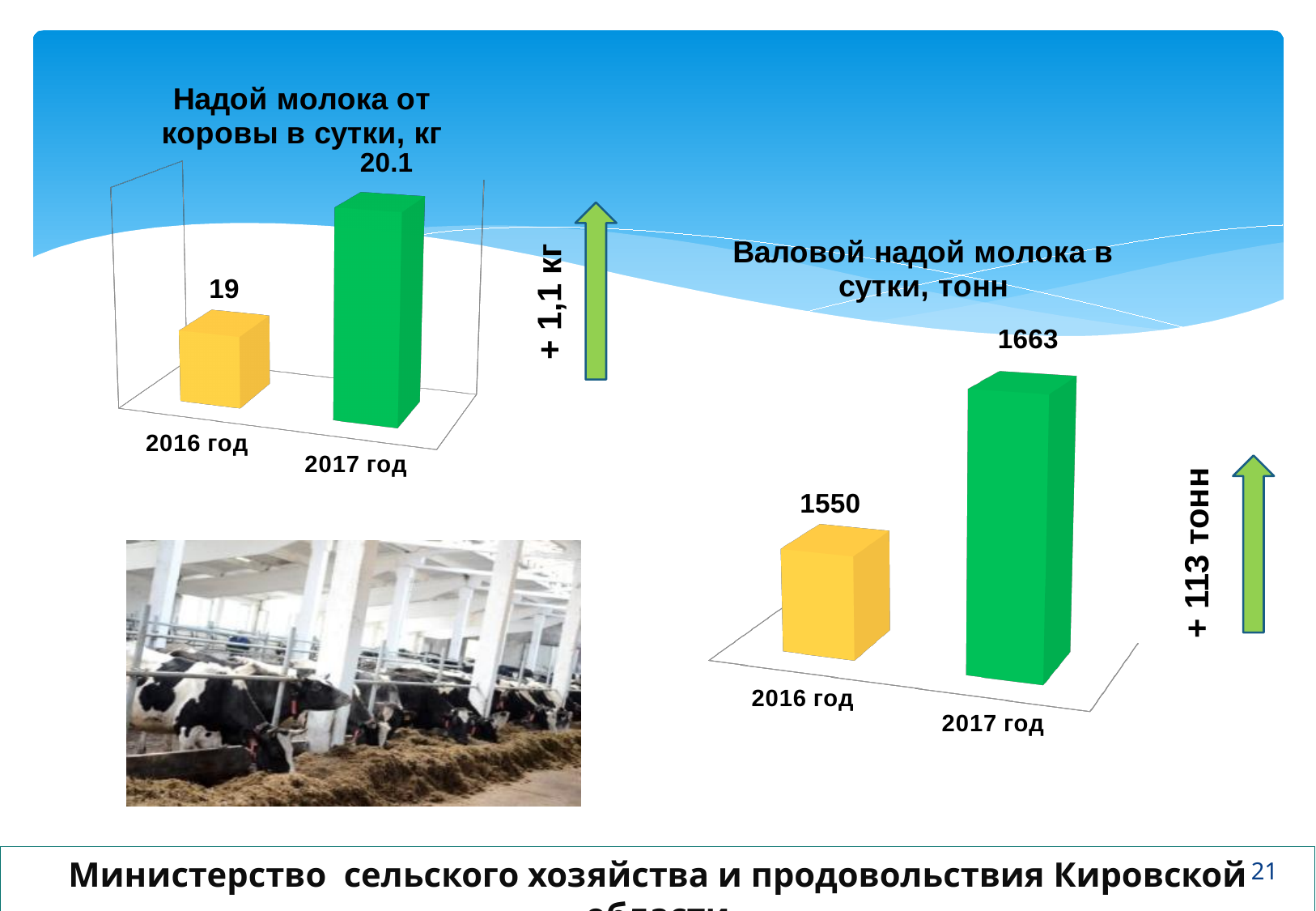
In the chart 'Надой молока от коровы в сутки, кг', do the values rise or fall from 2016 год to 2017 год? Rise How many categories are shown in the chart 'Валовой надой молока в сутки, тонн'? 2 In the chart 'Надой молока от коровы в сутки, кг', what is the value for 2017 год? 20.1 In the chart 'Валовой надой молока в сутки, тонн', what is the value for 2016 год? 1550 What kind of chart is 'Надой молока от коровы в сутки, кг'? Bar chart In the chart 'Валовой надой молока в сутки, тонн', which is larger: the value for 2016 год or 2017 год? 2017 год In the chart 'Валовой надой молока в сутки, тонн', what is the difference between the 2017 год and 2016 год values? 113 In the chart 'Валовой надой молока в сутки, тонн', what is the value for 2017 год? 1663 In the chart 'Надой молока от коровы в сутки, кг', which year has the lowest value? 2016 год In the chart 'Валовой надой молока в сутки, тонн', which year has the highest value? 2017 год In the chart 'Надой молока от коровы в сутки, кг', what is the value for 2016 год? 19 In the chart 'Надой молока от коровы в сутки, кг', by how much does the 2017 год value exceed the 2016 год value? 1.1